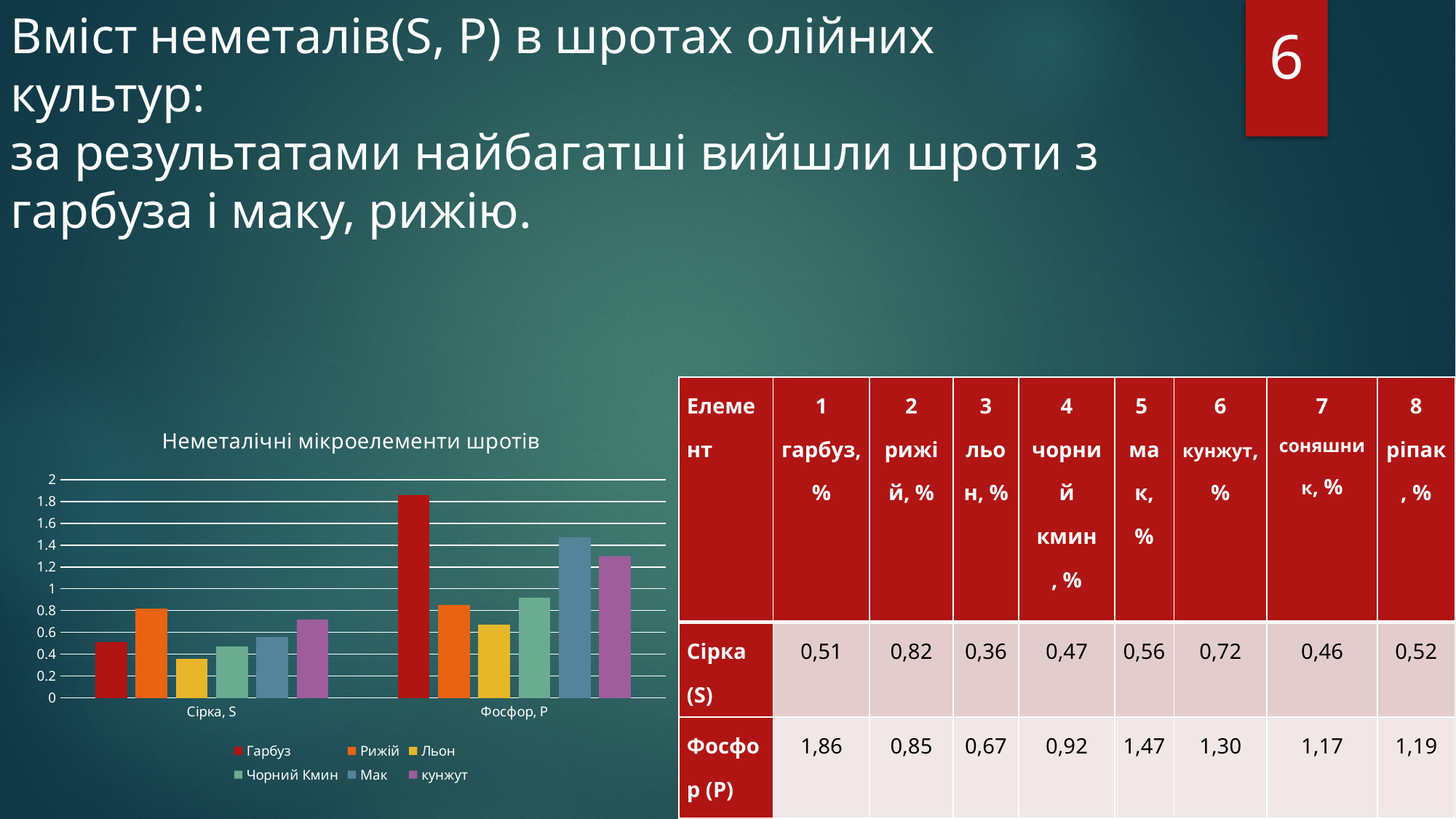
In the chart 'Неметалічні мікроелементи шротів', which series has the lowest bar for Фосфор, P? Льон In the chart 'Неметалічні мікроелементи шротів', which series has the highest bar for Сірка, S? Рижій In the chart 'Неметалічні мікроелементи шротів', is the value for кунжут at Фосфор, P greater or less than 1.2? greater In the chart 'Неметалічні мікроелементи шротів', is the value for Льон at Сірка, S greater or less than 0.4? less In the chart 'Неметалічні мікроелементи шротів', is the value for Гарбуз at Фосфор, P greater or less than 1.6? greater In the chart 'Неметалічні мікроелементи шротів', for Фосфор, P, which is larger: Мак or кунжут? Мак How many series does the legend of the chart 'Неметалічні мікроелементи шротів' list? 6 How many categories are shown on the x axis of the chart 'Неметалічні мікроелементи шротів'? 2 What is the title of the bar chart on the slide? Неметалічні мікроелементи шротів In the chart 'Неметалічні мікроелементи шротів', which series has the lowest bar for Сірка, S? Льон What kind of chart is 'Неметалічні мікроелементи шротів'? bar chart In the chart 'Неметалічні мікроелементи шротів', which series has the highest bar for Фосфор, P? Гарбуз